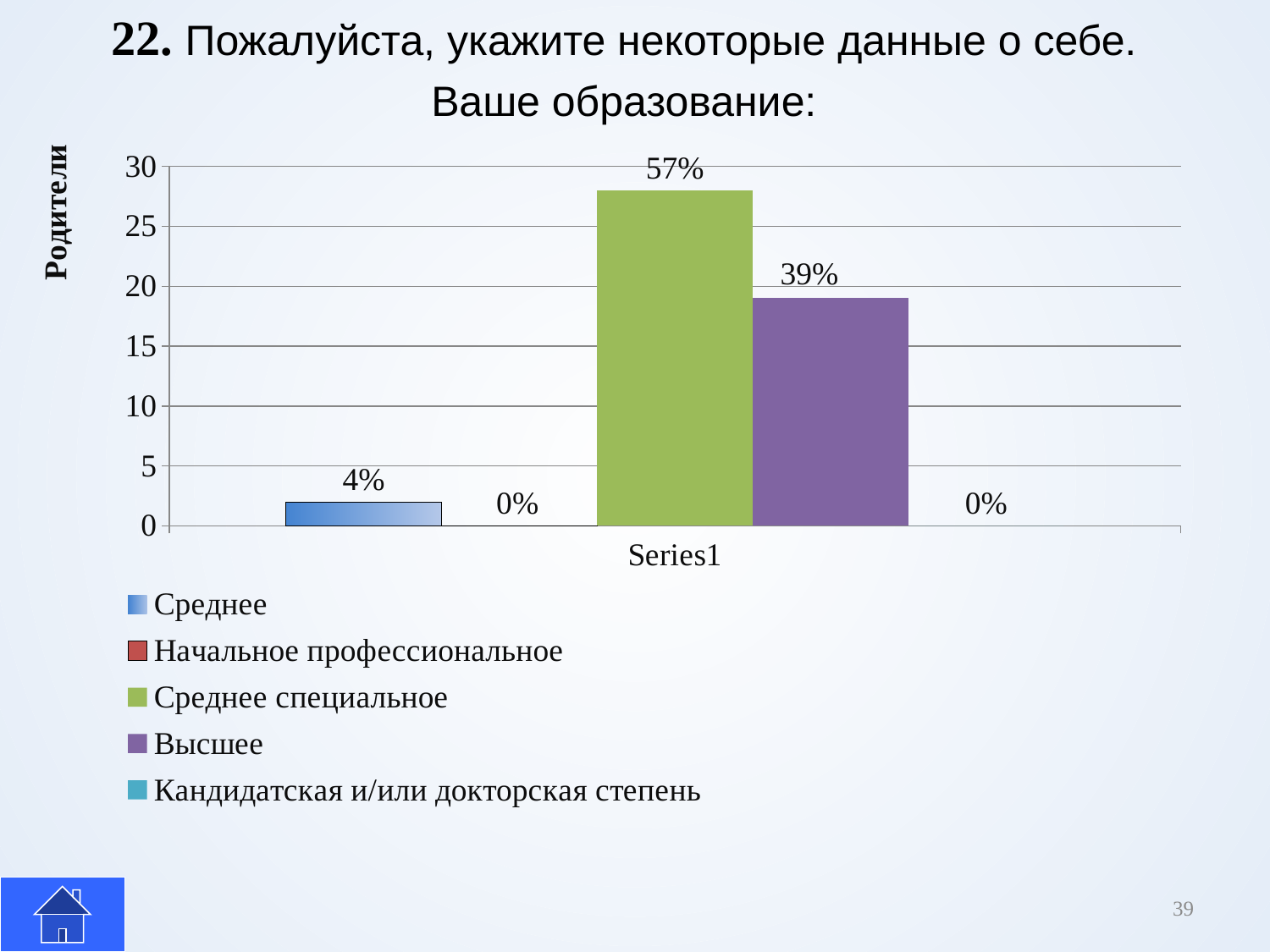
What kind of chart is shown on the slide? Bar chart What is the data label shown for Среднее? 4% How many series does the legend list? 5 Which is larger, the value for Среднее or the value for Высшее? Высшее Is the bar for Среднее специальное greater or less than 25 on the vertical axis? greater Which education level has the highest value? Среднее специальное What is the label on the vertical axis of the chart? Родители What is the data label shown for Высшее? 39% What is the difference between the labels for Среднее специальное and Высшее? 18% What is the data label shown for Среднее специальное? 57% Is the bar for Высшее greater or less than 15 on the vertical axis? greater What is the data label shown for Начальное профессиональное? 0%